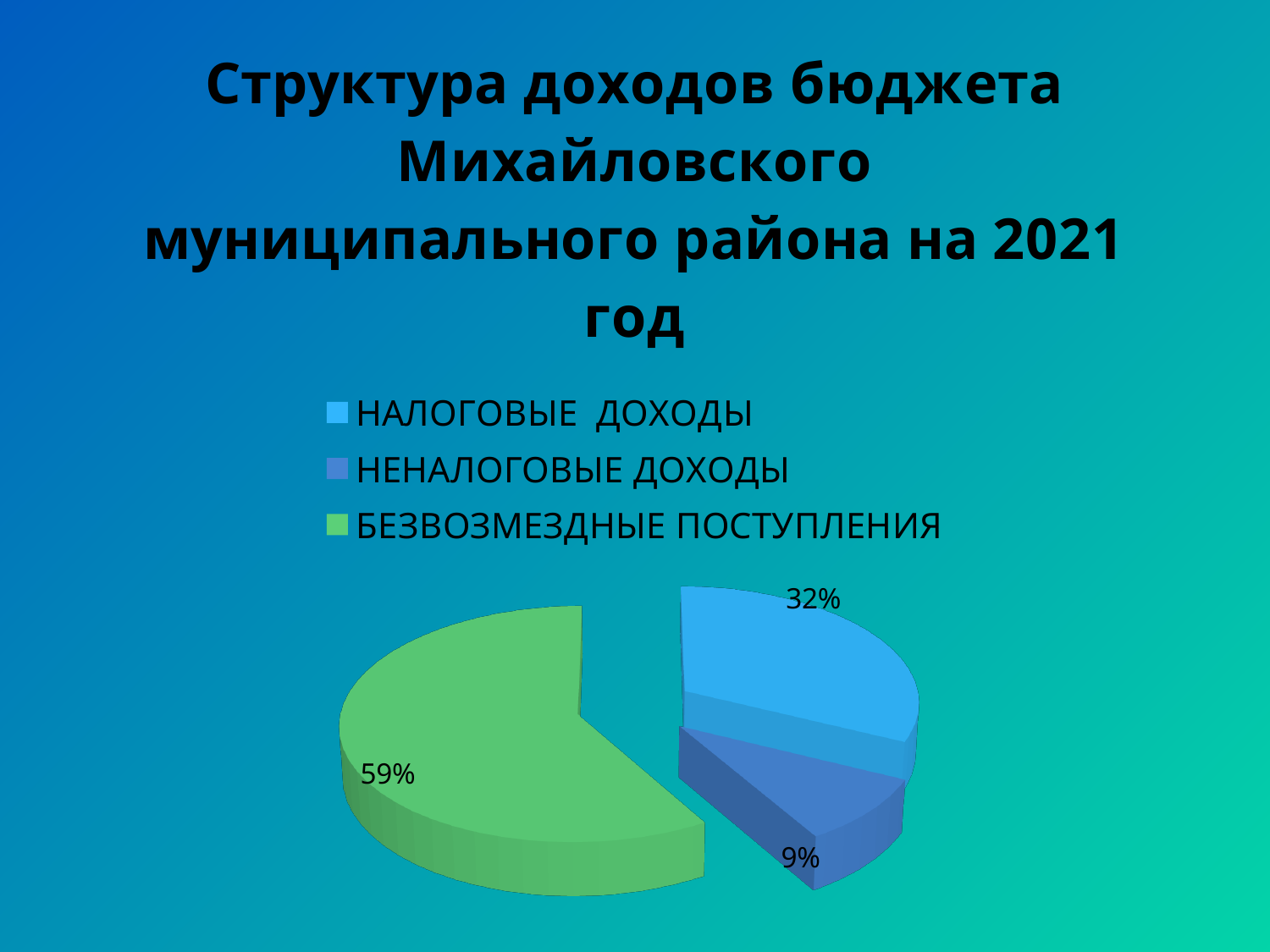
What is the difference in percentage points between НАЛОГОВЫЕ ДОХОДЫ and НЕНАЛОГОВЫЕ ДОХОДЫ? 23 What colour is the slice for БЕЗВОЗМЕЗДНЫЕ ПОСТУПЛЕНИЯ? Green Which category has the largest slice of the pie? БЕЗВОЗМЕЗДНЫЕ ПОСТУПЛЕНИЯ How many categories are shown in the pie chart? 3 Which is larger, the share for НАЛОГОВЫЕ ДОХОДЫ or the share for НЕНАЛОГОВЫЕ ДОХОДЫ? НАЛОГОВЫЕ ДОХОДЫ Which category has the smallest slice of the pie? НЕНАЛОГОВЫЕ ДОХОДЫ What is the title of the chart on the slide? Структура доходов бюджета Михайловского муниципального района на 2021 год What share of the pie does НАЛОГОВЫЕ ДОХОДЫ represent? 32% What is the difference in percentage points between БЕЗВОЗМЕЗДНЫЕ ПОСТУПЛЕНИЯ and НАЛОГОВЫЕ ДОХОДЫ? 27 What kind of chart is shown on the slide? Pie chart What share of the pie does НЕНАЛОГОВЫЕ ДОХОДЫ represent? 9% What share of the pie does БЕЗВОЗМЕЗДНЫЕ ПОСТУПЛЕНИЯ represent? 59%